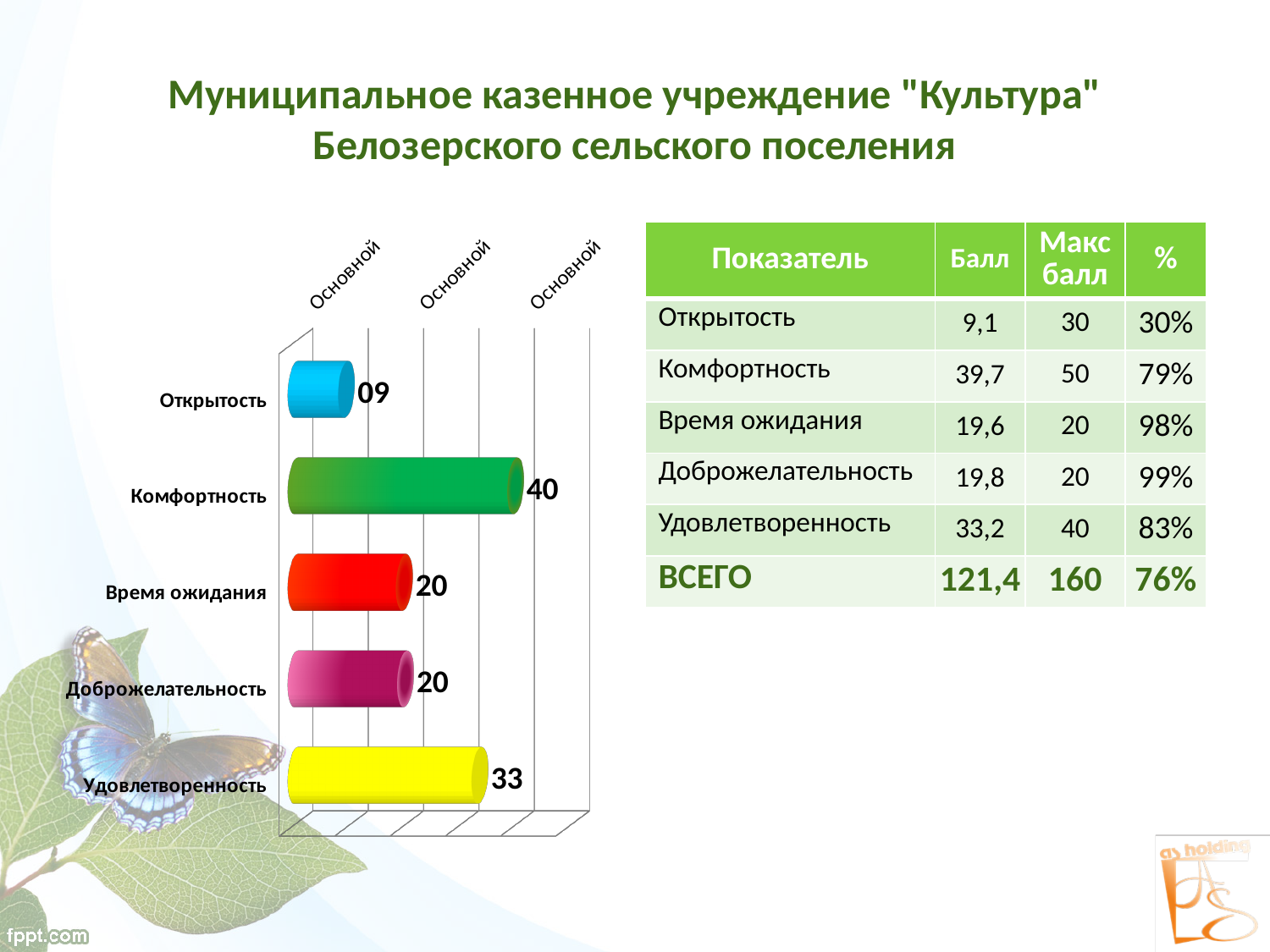
What value is shown for Комфортность in the chart? 40 Which is larger in the chart, the value for Удовлетворенность or the value for Время ожидания? Удовлетворенность How many categories are plotted in the chart? 5 What is the difference between the chart values for Удовлетворенность and Доброжелательность? 13 Which category has the lowest value in the chart? Открытость What value is shown for Время ожидания in the chart? 20 What kind of chart is shown on the slide? Bar chart What value is shown for Открытость in the chart? 09 Which category has the highest value in the chart? Комфортность What value is shown for Удовлетворенность in the chart? 33 What is the difference between the chart values for Комфортность and Удовлетворенность? 7 What colour is the bar for Удовлетворенность in the chart? Yellow